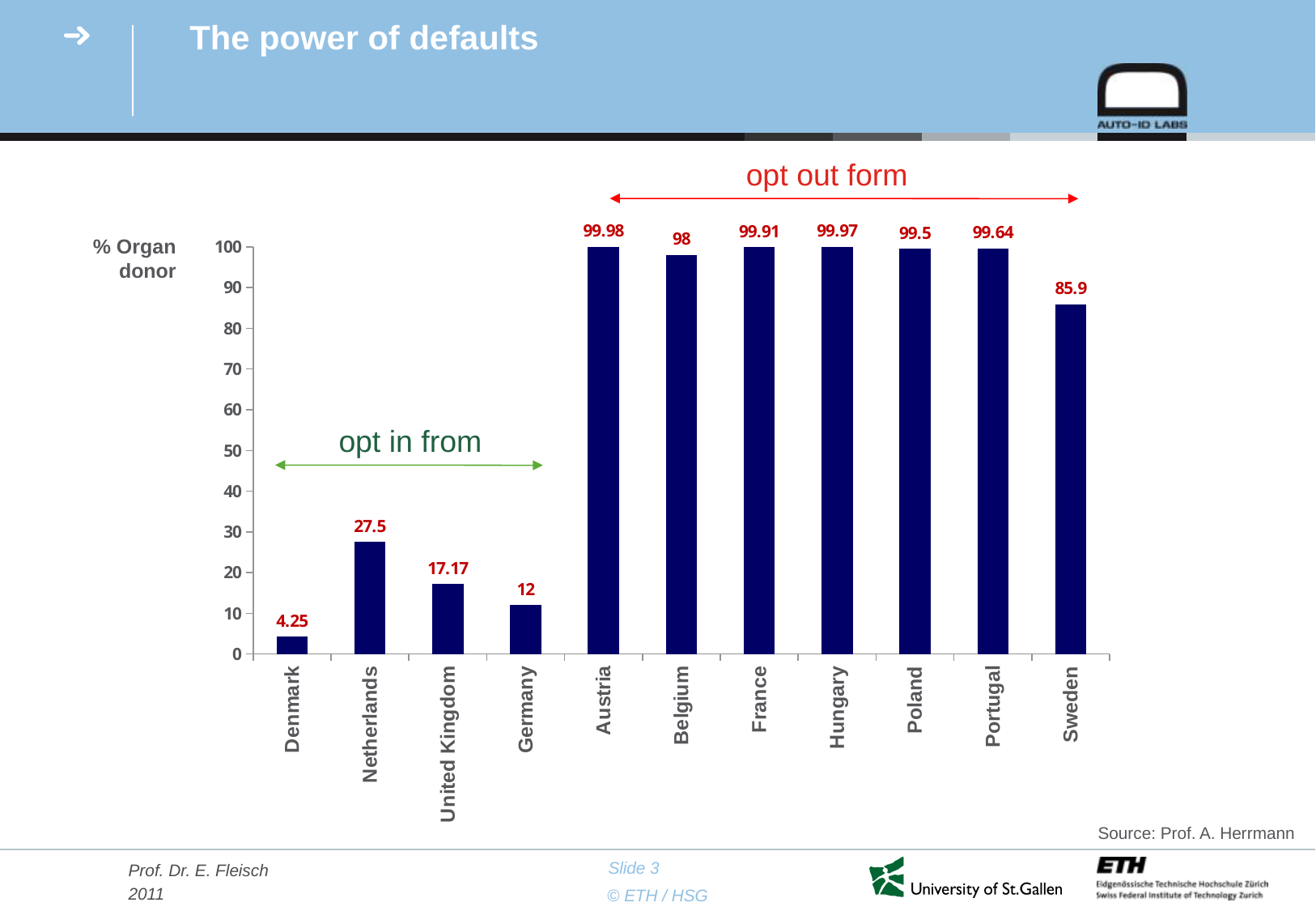
Which country has the highest % organ donor value? Austria What kind of chart is shown on the slide? Bar chart What is the difference between the values for the Netherlands and Denmark? 23.25 What is the % organ donor value for Denmark? 4.25 What is the % organ donor value for Sweden? 85.9 Is the value for Poland greater or less than 90? greater Which has a higher % organ donor value, Belgium or Sweden? Belgium What is the % organ donor value for the United Kingdom? 17.17 Which country has the lowest % organ donor value? Denmark How many countries are shown on the chart? 11 What is the % organ donor value for Germany? 12 Which countries are grouped under the 'opt in from' label? Denmark, Netherlands, United Kingdom, Germany